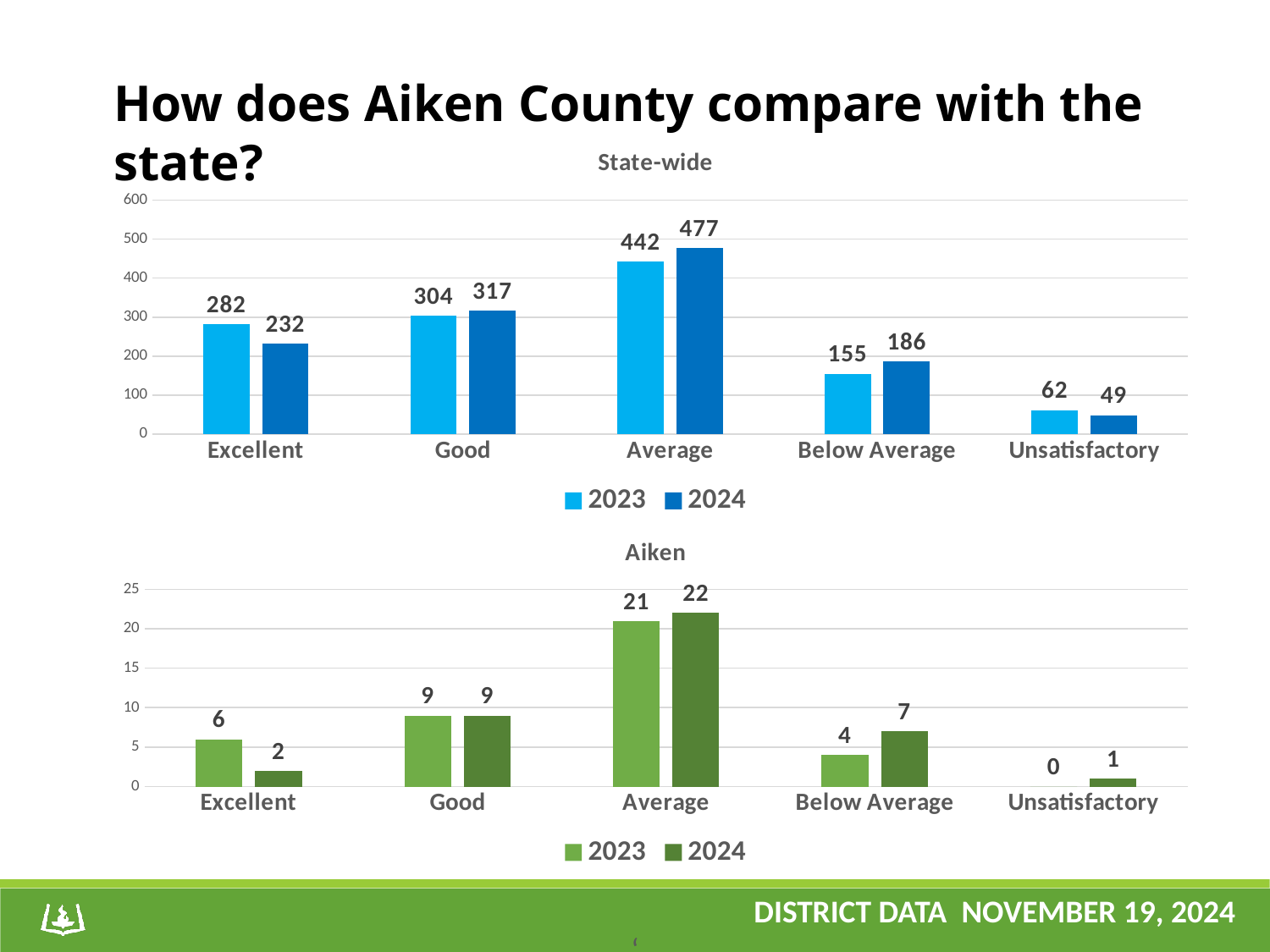
How many series does the legend of the State-wide chart list? 2 How many categories are shown on the x axis of the Aiken chart? 5 In the Aiken chart, what is the difference between the 2023 and 2024 values for Below Average? 3 In the State-wide chart, what is the difference between the 2023 and 2024 values for Excellent? 50 In the State-wide chart, which category has the lowest 2024 value? Unsatisfactory In the State-wide chart, is the 2024 value for Good greater or less than 300? greater In the State-wide chart, what is the 2024 value for Average? 477 In the State-wide chart, what is the 2023 value for Below Average? 155 In the Aiken chart, which is larger for Excellent: the 2023 value or the 2024 value? 2023 In the Aiken chart, what is the 2023 value for Unsatisfactory? 0 In the Aiken chart, what is the 2024 value for Below Average? 7 In the State-wide chart, which category has the highest 2023 value? Average